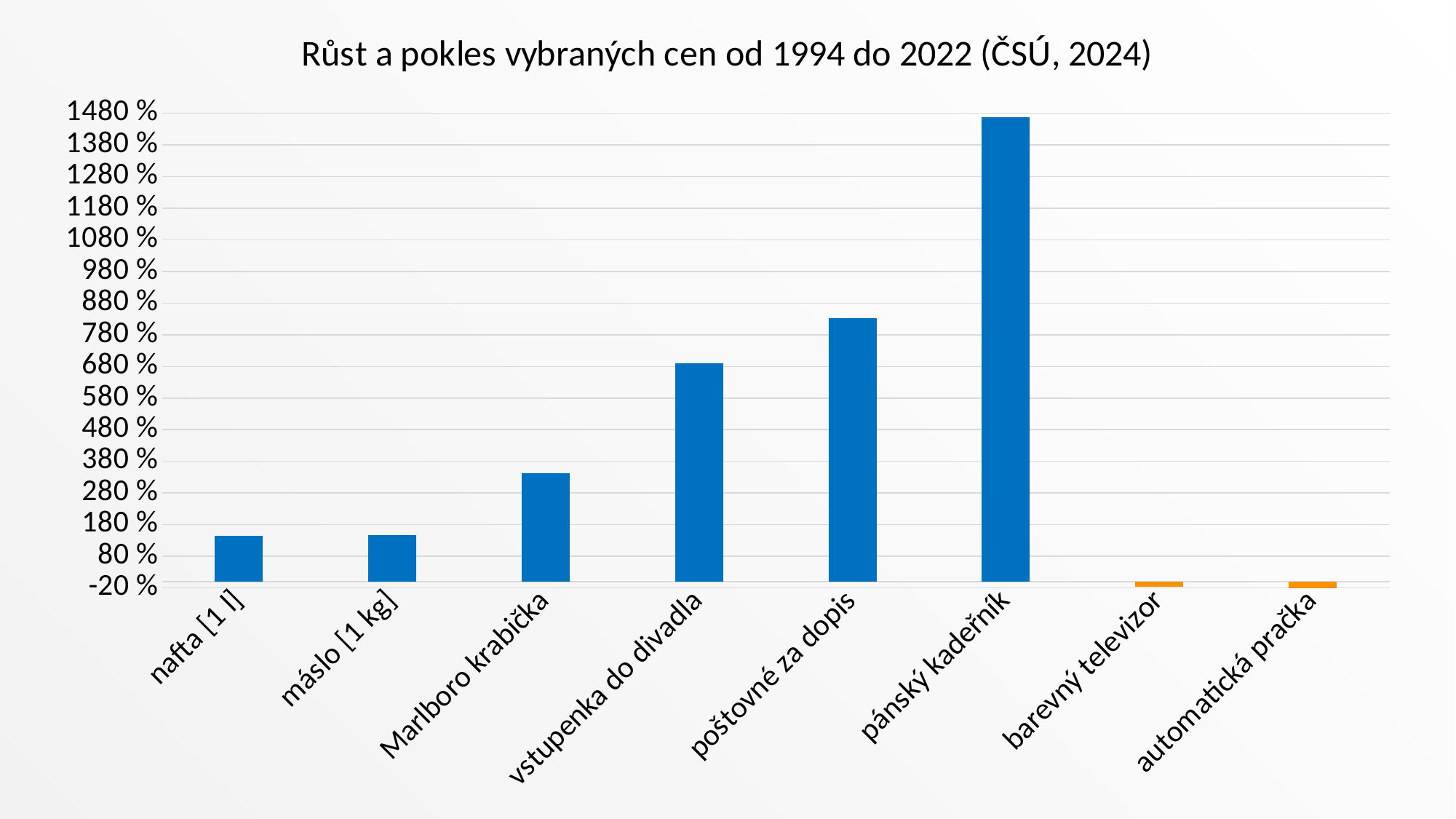
Which category has the highest value? pánský kadeřník Is the value for vstupenka do divadla greater or less than 780 %? less Is the value for Marlboro krabička greater or less than 280 %? greater What is the title of the chart? Růst a pokles vybraných cen od 1994 do 2022 (ČSÚ, 2024) How many categories are plotted on the chart? 8 What kind of chart is shown on the slide? bar chart Which is larger, the value for poštovné za dopis or the value for vstupenka do divadla? poštovné za dopis Is the value for pánský kadeřník greater or less than 1380 %? greater Which is larger, the value for Marlboro krabička or the value for máslo [1 kg]? Marlboro krabička Which categories are shown with orange bars instead of blue? barevný televizor and automatická pračka